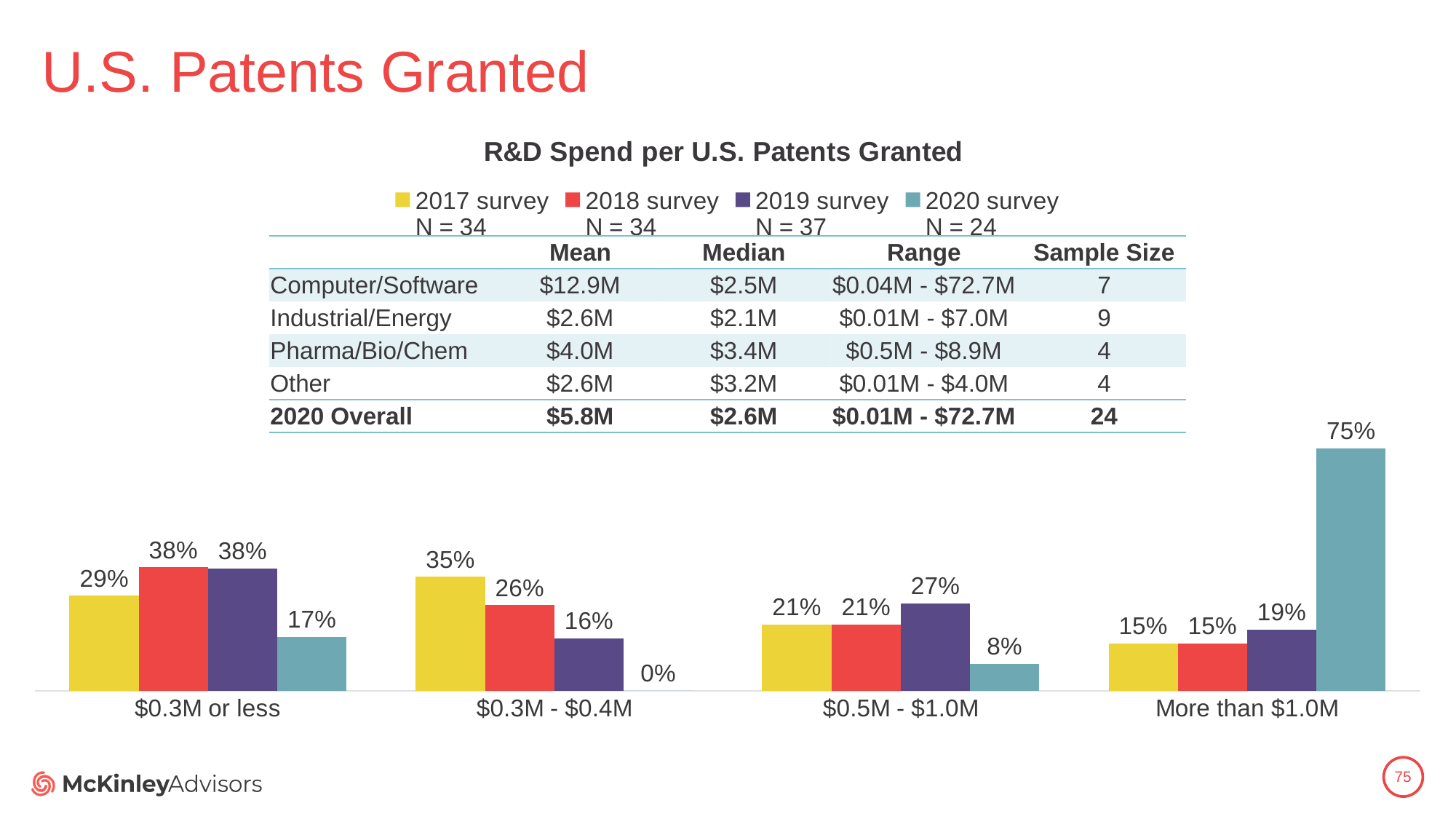
Which category has the lowest value for the 2017 survey? More than $1.0M Which is larger in the '$0.3M or less' category: the 2017 survey value or the 2018 survey value? 2018 survey How many series does the chart legend list? 4 What is the value for the 2020 survey in the '$0.3M - $0.4M' category? 0% How many categories are shown on the x axis of the chart? 4 Which category has the highest value for the 2020 survey? More than $1.0M What is the difference between the 2020 survey and the 2019 survey values in the 'More than $1.0M' category? 56% What is the value for the 2017 survey in the '$0.3M - $0.4M' category? 35% What is the value for the 2019 survey in the '$0.5M - $1.0M' category? 27% What kind of chart is shown on the slide? Bar chart What is the value for the 2020 survey in the 'More than $1.0M' category? 75% What is the title of the chart? R&D Spend per U.S. Patents Granted